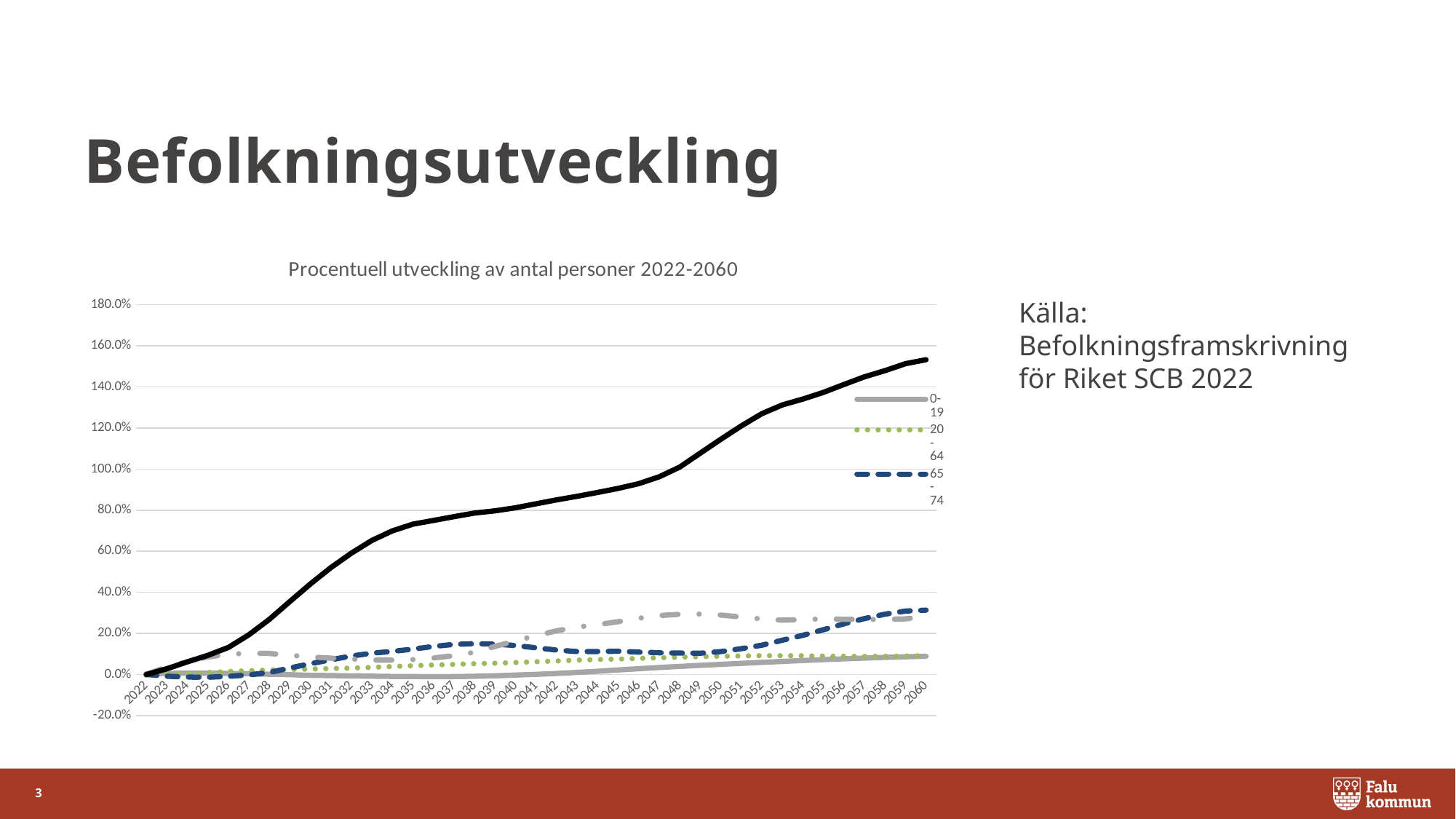
What kind of chart is shown on the slide? line chart Is the value of the black solid line in 2035 greater or less than 60%? greater How many years are shown along the x axis of the chart? 39 In 2060, which is larger: the value for the 65-74 series or the value for the 0-19 series? 65-74 How many series does the chart's legend list? 3 Is the value for the 0-19 series in 2060 greater or less than 20%? less Is the value for the 65-74 series in 2060 greater or less than 20%? greater What is the highest value shown on the y axis of the chart? 180.0% Does the black solid line rise or fall from 2022 to 2060? rise What is the title of the chart? Procentuell utveckling av antal personer 2022-2060